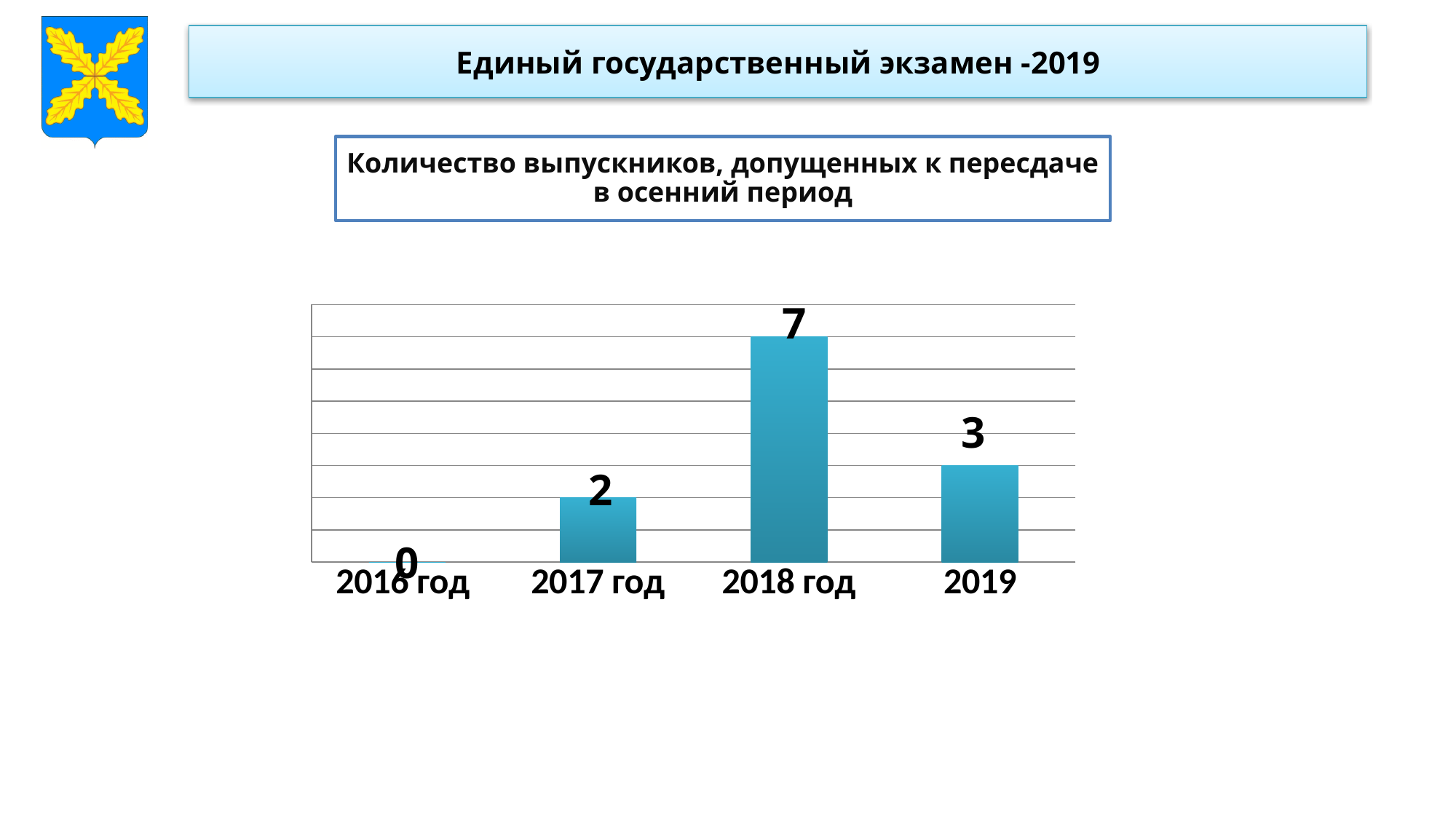
What is the value for 2017 год? 2 What is the value for 2019? 3 Which is larger, the value for 2017 год or the value for 2019? 2019 What is the value for 2016 год? 0 What is the title shown above the chart? Количество выпускников, допущенных к пересдаче в осенний период What is the difference between the values for 2019 and 2017 год? 1 What kind of chart is shown on the slide? bar chart How many categories are shown on the x axis? 4 What is the value for 2018 год? 7 Which year has the lowest value? 2016 год Which year has the highest value? 2018 год What is the difference between the values for 2018 год and 2019? 4